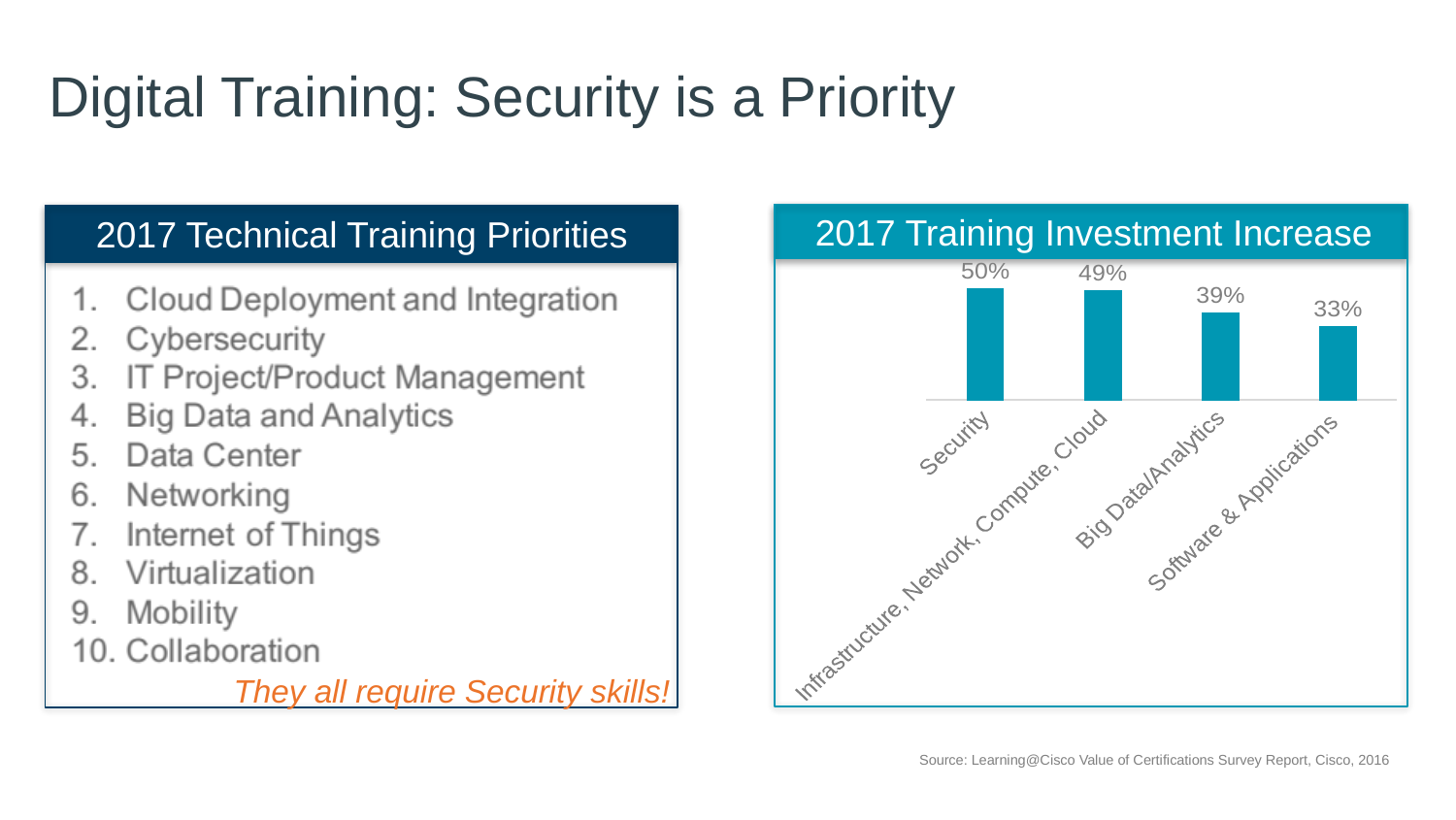
What is the value for Software & Applications in the 2017 Training Investment Increase chart? 33% What is the value for Infrastructure, Network, Compute, Cloud in the 2017 Training Investment Increase chart? 49% What kind of chart is the 2017 Training Investment Increase chart? Bar chart What is the difference between the values for Infrastructure, Network, Compute, Cloud and Big Data/Analytics in the 2017 Training Investment Increase chart? 10% Which category has the highest value in the 2017 Training Investment Increase chart? Security Which category has the lowest value in the 2017 Training Investment Increase chart? Software & Applications What is the value for Big Data/Analytics in the 2017 Training Investment Increase chart? 39% What is the difference between the values for Security and Software & Applications in the 2017 Training Investment Increase chart? 17% What is the value for Security in the 2017 Training Investment Increase chart? 50% How many categories are shown in the 2017 Training Investment Increase chart? 4 In the 2017 Training Investment Increase chart, which is larger: Big Data/Analytics or Software & Applications? Big Data/Analytics Do the values in the 2017 Training Investment Increase chart rise or fall from left to right? Fall